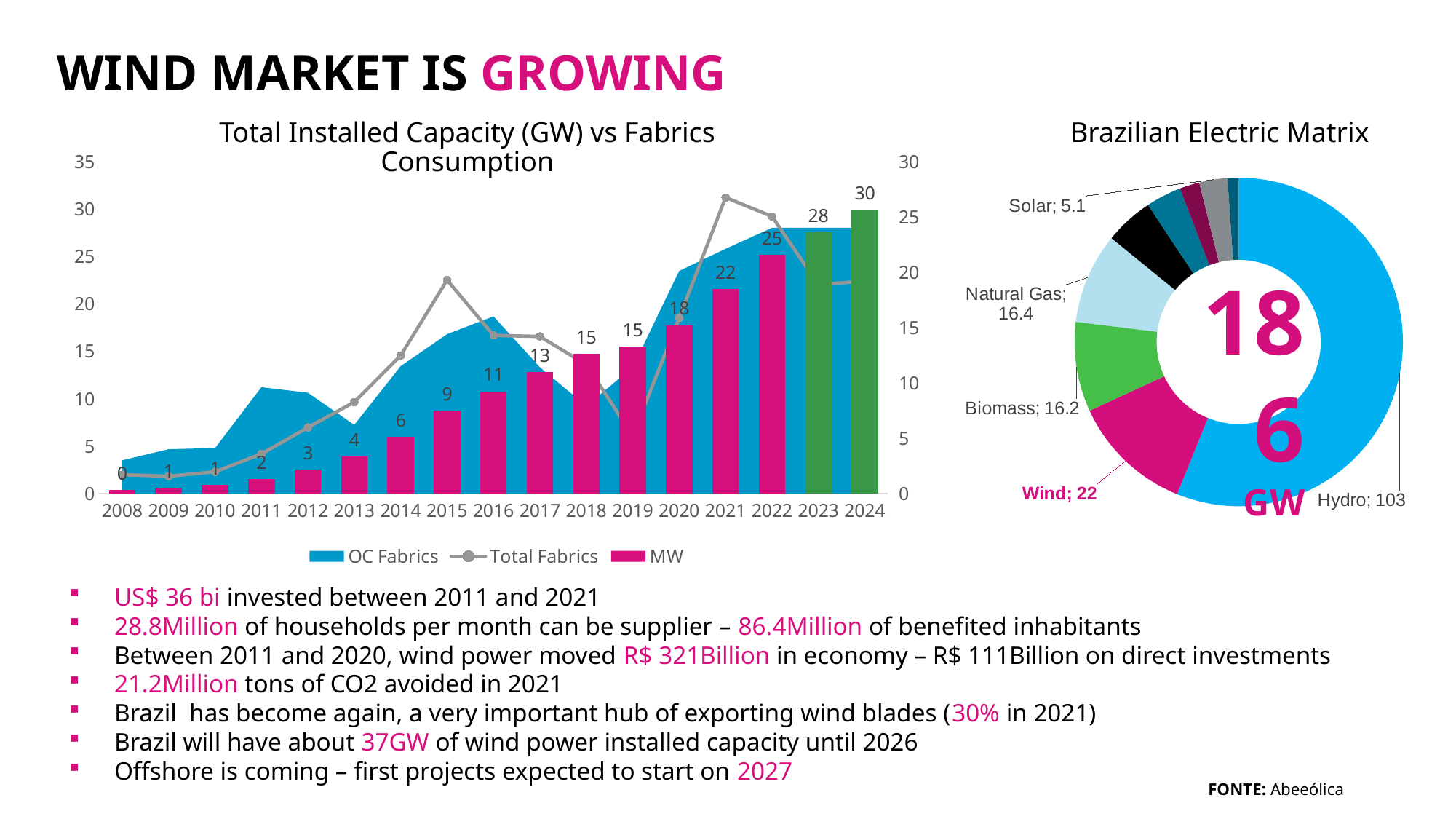
How many years are shown on the x axis of the 'Total Installed Capacity (GW) vs Fabrics Consumption' chart? 17 How many series does the legend of the 'Total Installed Capacity (GW) vs Fabrics Consumption' chart list? 3 In the 'Total Installed Capacity (GW) vs Fabrics Consumption' chart, what is the MW value for 2024? 30 In the 'Total Installed Capacity (GW) vs Fabrics Consumption' chart, do the MW bars generally rise or fall from 2008 to 2024? rise In the 'Total Installed Capacity (GW) vs Fabrics Consumption' chart, what is the difference between the MW values for 2022 and 2021? 3 In the 'Total Installed Capacity (GW) vs Fabrics Consumption' chart, which year has the larger MW value, 2016 or 2017? 2017 In the 'Brazilian Electric Matrix' chart, what is the value for Wind? 22 In the 'Total Installed Capacity (GW) vs Fabrics Consumption' chart, what is the MW value for 2021? 22 In the 'Brazilian Electric Matrix' chart, which labelled source has the largest slice? Hydro What kind of chart is the 'Brazilian Electric Matrix' chart? pie (donut) chart In the 'Total Installed Capacity (GW) vs Fabrics Consumption' chart, which year has the highest MW bar? 2024 In the 'Brazilian Electric Matrix' chart, what is the value for Hydro? 103